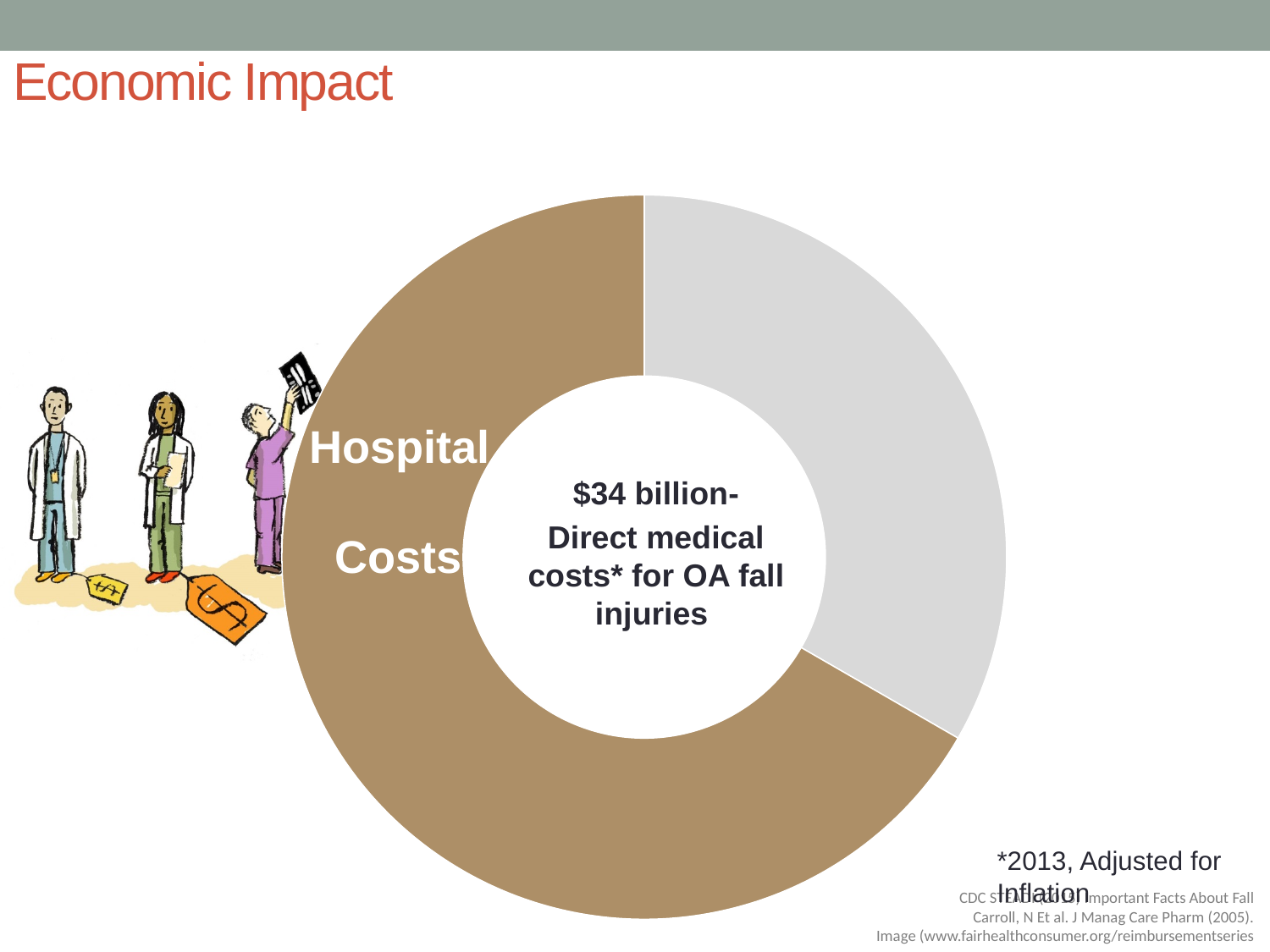
What is the only slice label shown on the donut chart? Hospital Costs Which slice of the donut chart is the largest? Hospital Costs Which is larger in the donut chart: the Hospital Costs slice or the grey slice? Hospital Costs How many slices does the donut chart have? 2 Does the Hospital Costs slice cover more or less than half of the donut chart? more What kind of chart is shown on the slide? donut chart What dollar amount is printed in the centre of the donut chart? $34 billion